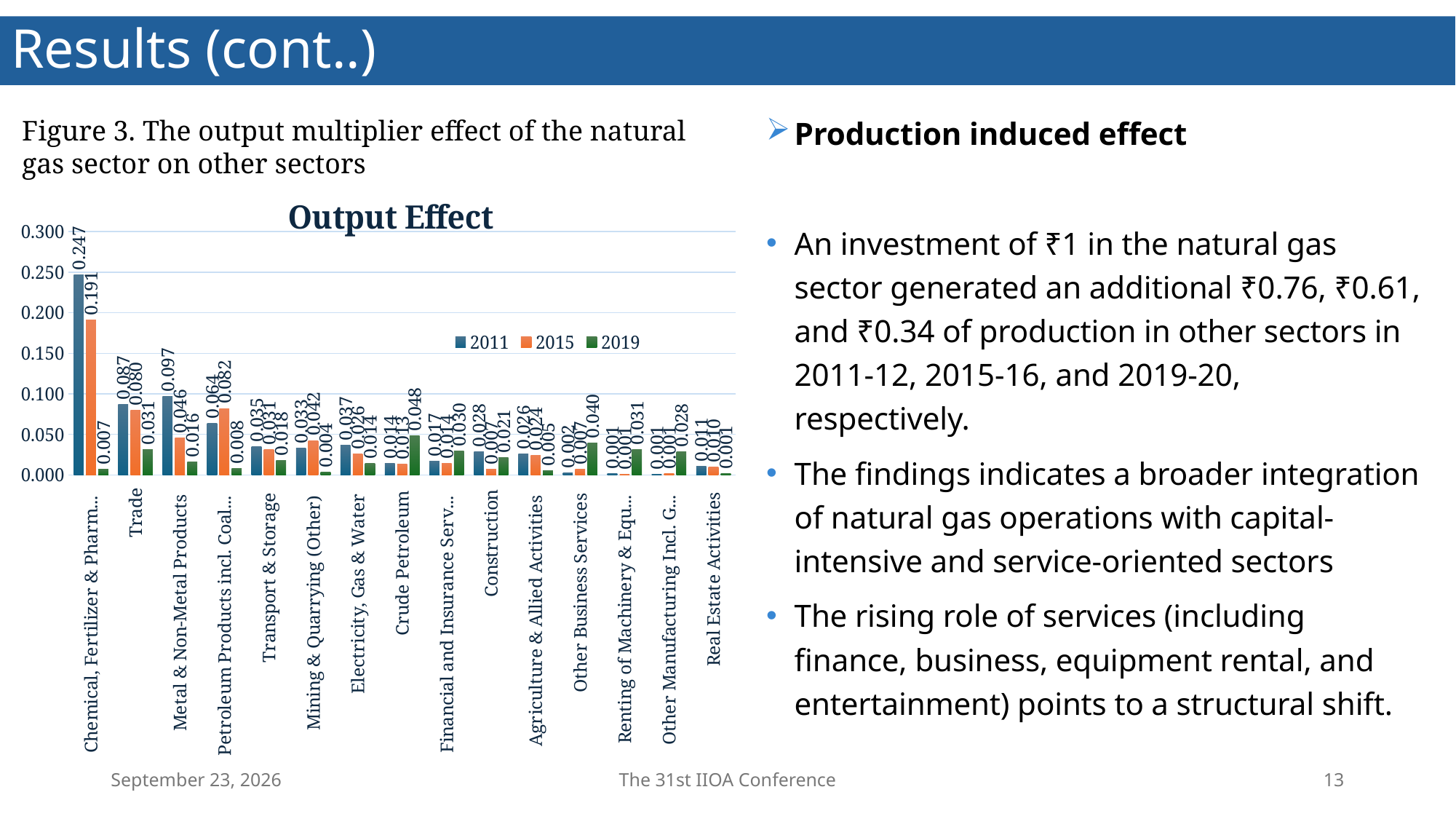
How many sector categories are shown on the x axis of the Output Effect chart? 15 Which sector has the highest 2019 value in the Output Effect chart? Crude Petroleum For Other Business Services, which year has the larger value, 2011 or 2019? 2019 What is the 2019 value for Crude Petroleum in the Output Effect chart? 0.048 What is the 2011 value for Trade in the Output Effect chart? 0.087 Is the 2011 value for Trade greater or less than 0.050? greater Which sector has the highest 2011 value in the Output Effect chart? Chemical, Fertilizer & Pharm... What is the difference between the 2011 and 2015 values for Metal & Non-Metal Products? 0.051 What is the 2015 value for Mining & Quarrying (Other) in the Output Effect chart? 0.042 What is the title of the chart on the slide? Output Effect What type of chart is shown on the slide? Bar chart How many series does the legend of the Output Effect chart list? 3